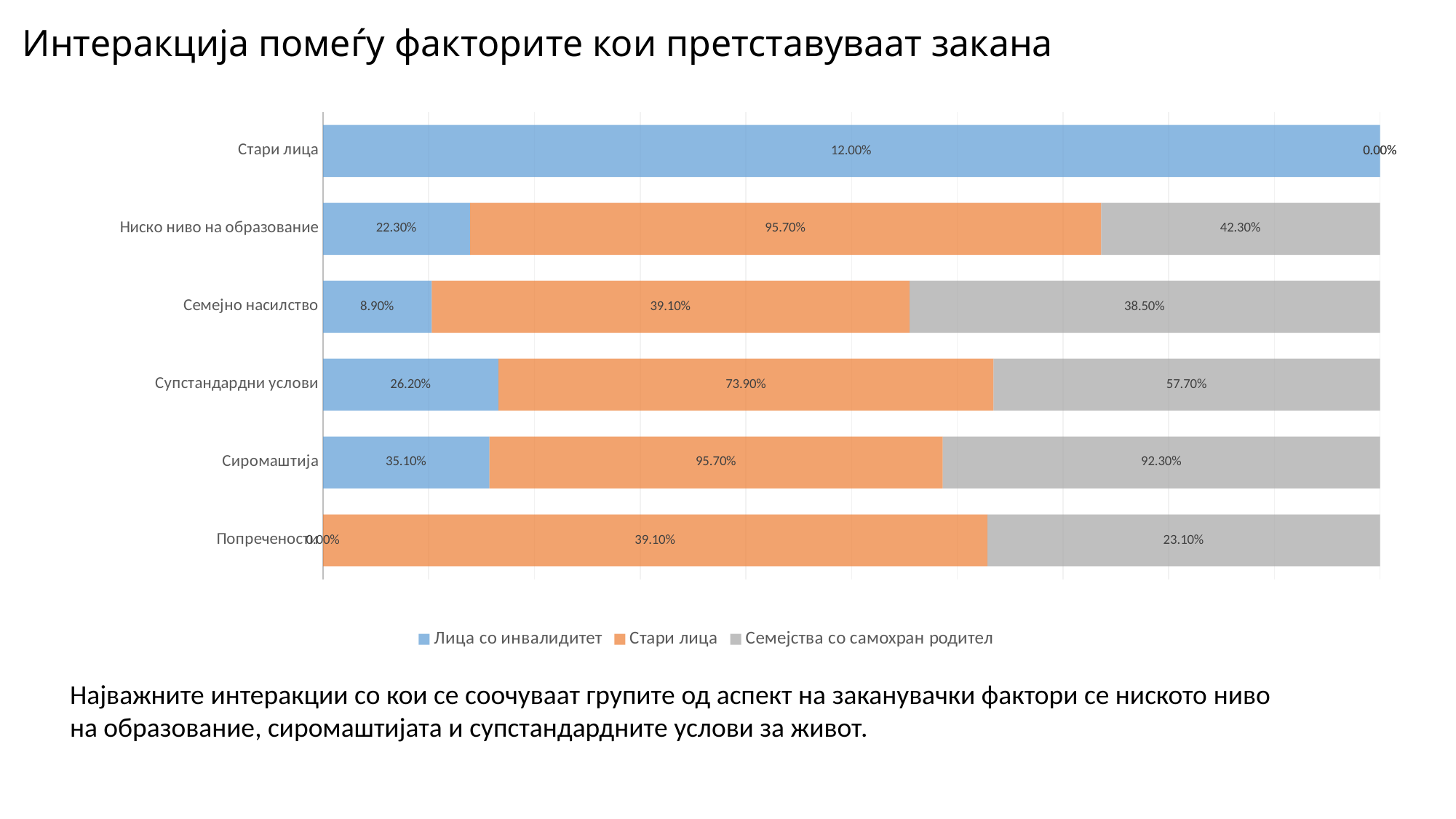
Which colour represents the Семејства со самохран родител series in the legend? Grey Which category has the highest value for Семејства со самохран родител? Сиромаштија What is the value for Стари лица (series) in the Семејно насилство category? 39.10% Which category has the highest value for Лица со инвалидитет? Сиромаштија What is the value for Лица со инвалидитет in the Сиромаштија category? 35.10% What is the value for Семејства со самохран родител in the Супстандардни услови category? 57.70% How many series does the legend list? 3 What kind of chart is shown on the slide? Bar chart How many categories are shown on the vertical axis of the chart? 6 Which is larger in the Семејно насилство category: the value for Стари лица (series) or for Семејства со самохран родител? Стари лица What is the difference between the Стари лица series value and the Лица со инвалидитет value in the Ниско ниво на образование category? 73.40% What is the value for Лица со инвалидитет in the Попреченост category? 0.00%